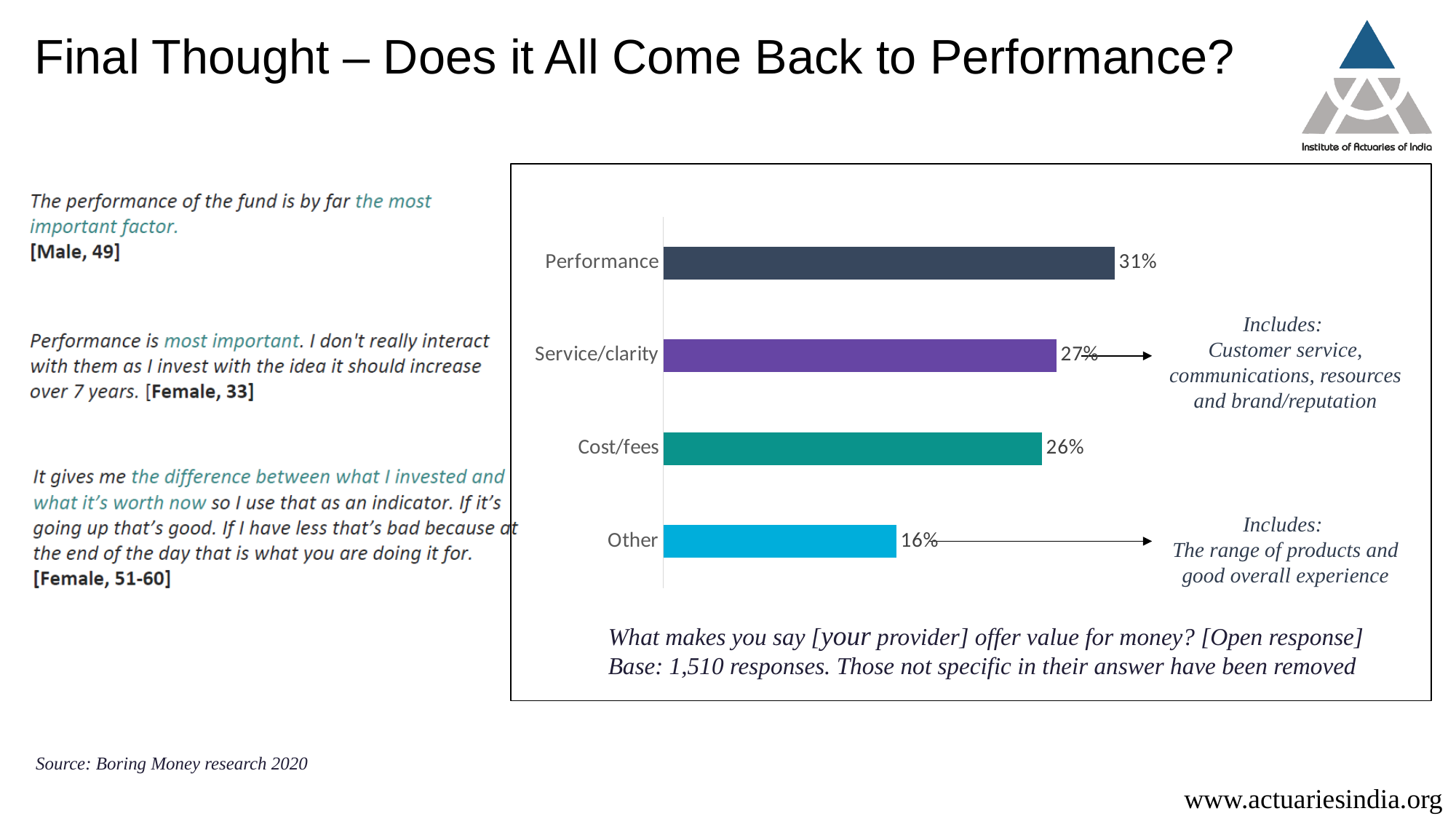
Which is larger, the value for Performance or the value for Cost/fees? Performance Which category has the lowest value? Other What is the value for Other? 16% How many categories are shown in the chart? 4 What is the difference between the values for Service/clarity and Cost/fees? 1% What kind of chart is shown on the slide? Bar chart What is the difference between the values for Performance and Other? 15% Which category has the highest value? Performance What is the value for Performance? 31% What is the value for Service/clarity? 27% What is the value for Cost/fees? 26% What colour is the bar for Cost/fees? Teal